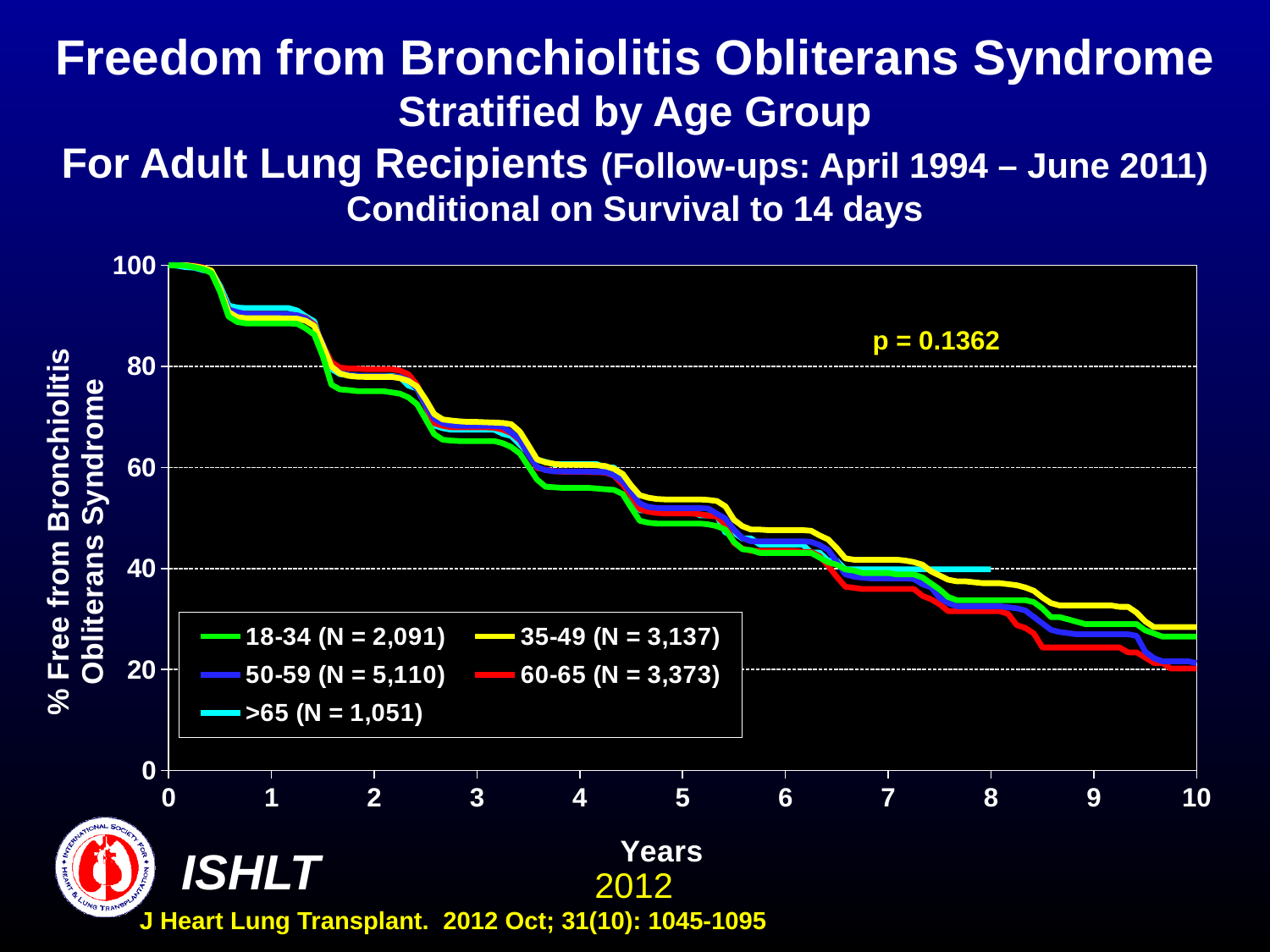
Is the value for the 35-49 group at year 10 greater or less than 20? greater What kind of chart is shown on the slide? line chart At year 10, which group has the higher value: 35-49 or 60-65? 35-49 Is the value for the 35-49 group at year 3 greater or less than 60? greater Which age group has the highest value at year 10? 35-49 Do the values rise or fall as the years increase along the x axis? fall What p-value is printed on the chart? p = 0.1362 Is the value for the 18-34 group at year 4 greater or less than 60? less How many series does the legend list? 5 According to the legend, what is N for the 50-59 age group? 5,110